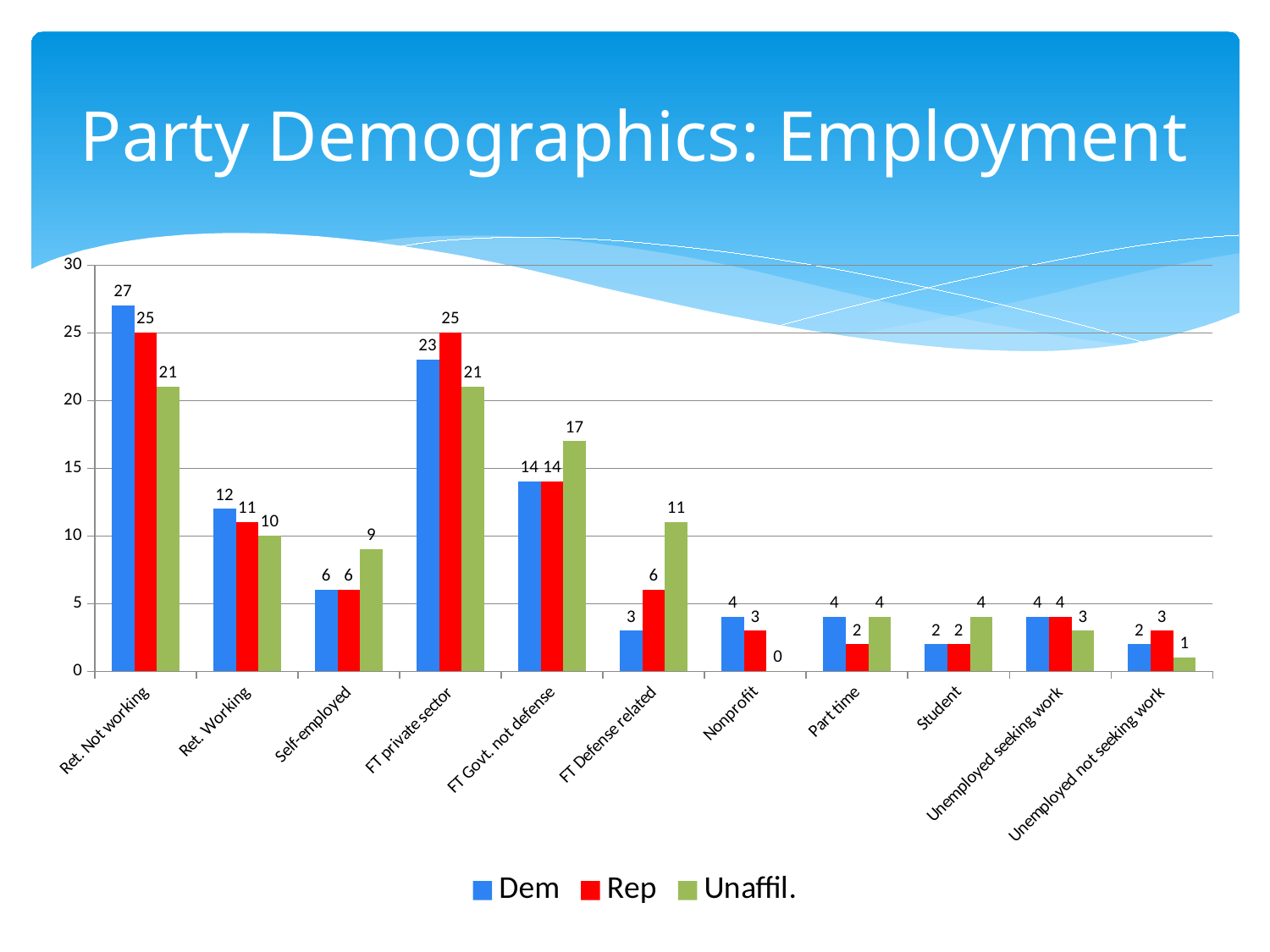
What is the title of the slide? Party Demographics: Employment Which is larger for FT Defense related, the Rep value or the Unaffil. value? Unaffil. Which category has the lowest Unaffil. value? Nonprofit What is the Rep value for FT private sector? 25 How many series does the legend list? 3 How many employment categories are shown on the x axis? 11 What is the difference between the Unaffil. and Dem values for FT Govt. not defense? 3 What colour represents the Rep series in the legend? Red What kind of chart is shown on the slide? Bar chart Which category has the highest Dem value? Ret. Not working What is the Unaffil. value for FT Defense related? 11 What is the Dem value for Ret. Not working? 27